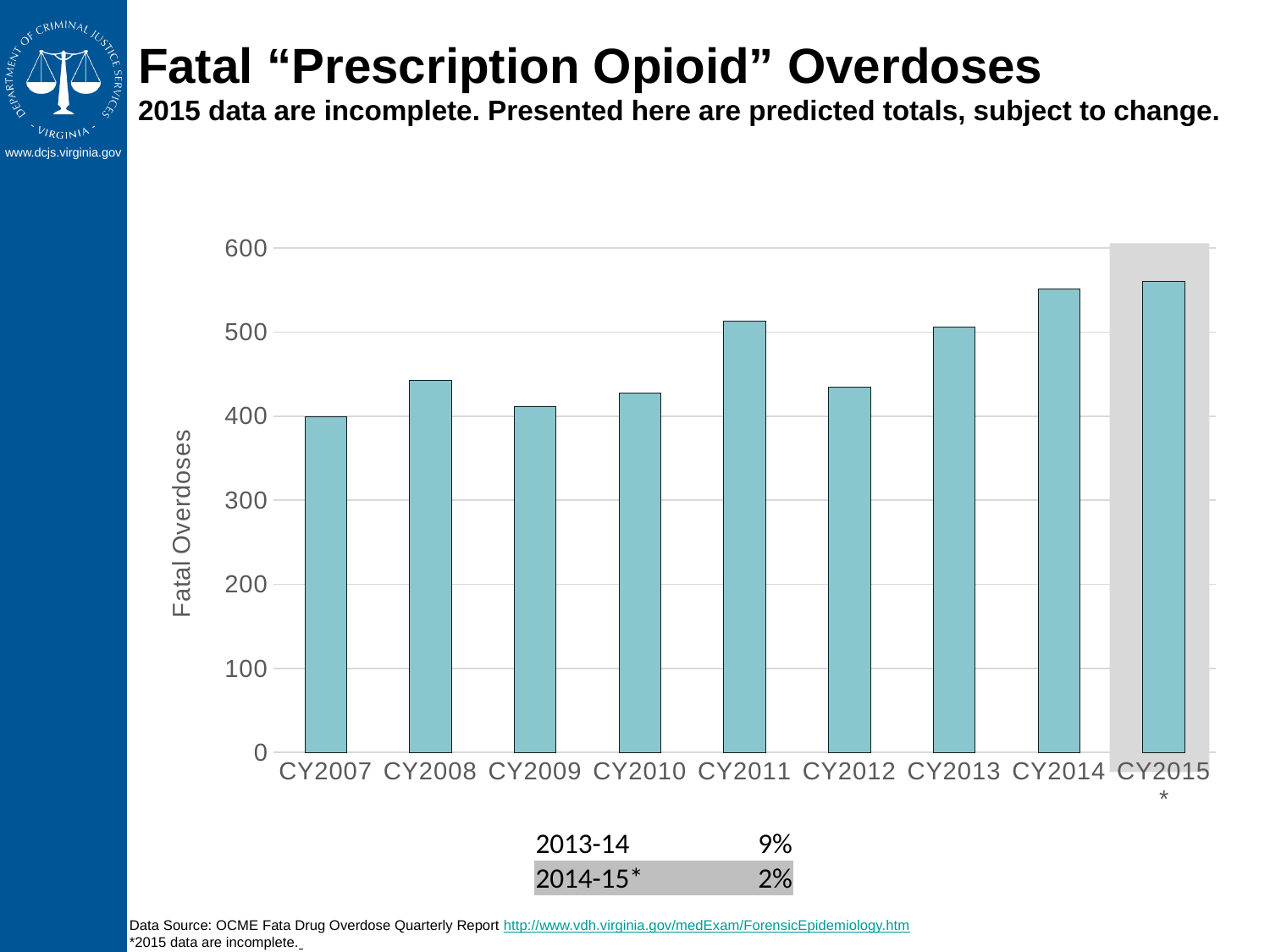
Is the value for CY2011 greater or less than 500? greater Is the value for CY2008 greater or less than 500? less What kind of chart is shown on the slide? bar chart Is the value for CY2010 greater or less than 400? greater Do fatal prescription opioid overdoses generally rise or fall from CY2007 to CY2015? rise What is the title of the y axis? Fatal Overdoses Which has more fatal overdoses, CY2008 or CY2009? CY2008 Which has more fatal overdoses, CY2011 or CY2012? CY2011 How many calendar years are plotted on the x axis? 9 What percentage change is shown for 2013-14 below the chart? 9%